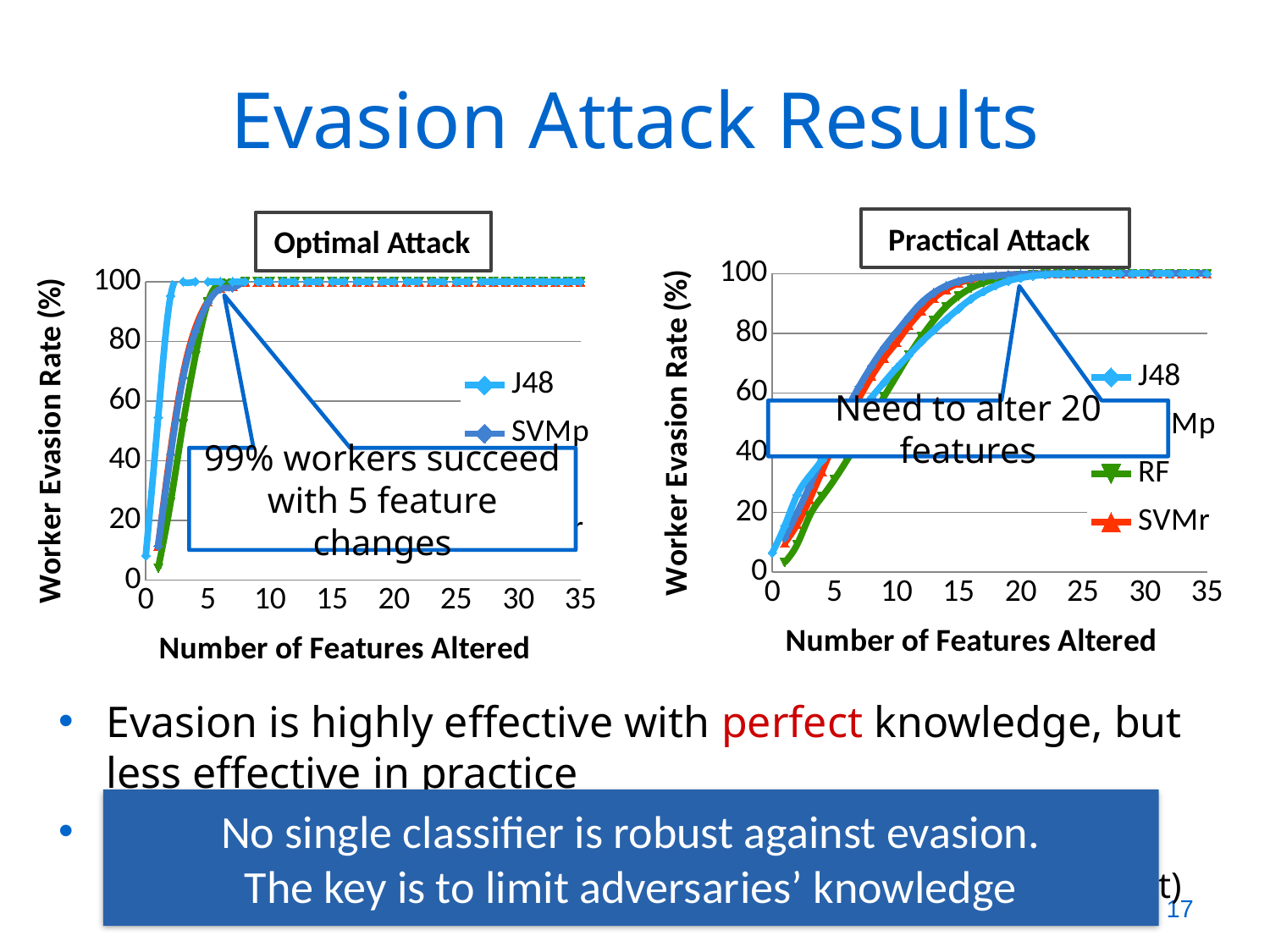
In the Practical Attack chart, is the worker evasion rate for SVMr at 20 features altered greater or less than 80? greater In the Optimal Attack chart, does the worker evasion rate rise or fall as the number of features altered increases? Rise How many series does the legend of the Practical Attack chart list? 4 In the Practical Attack chart, does the worker evasion rate rise or fall as the number of features altered increases? Rise What is the label of the y-axis on the Practical Attack chart? Worker Evasion Rate (%) In the Optimal Attack chart, is the worker evasion rate for J48 at 10 features altered greater or less than 80? greater What is the label of the x-axis on the Optimal Attack chart? Number of Features Altered In the Optimal Attack chart, at 2 features altered, which has the higher worker evasion rate, J48 or SVMp? J48 What kind of chart is the Optimal Attack chart? Line chart In the Practical Attack chart, is the worker evasion rate for J48 at 5 features altered greater or less than 60? less In the Practical Attack chart, at 5 features altered, which has the higher worker evasion rate, J48 or RF? J48